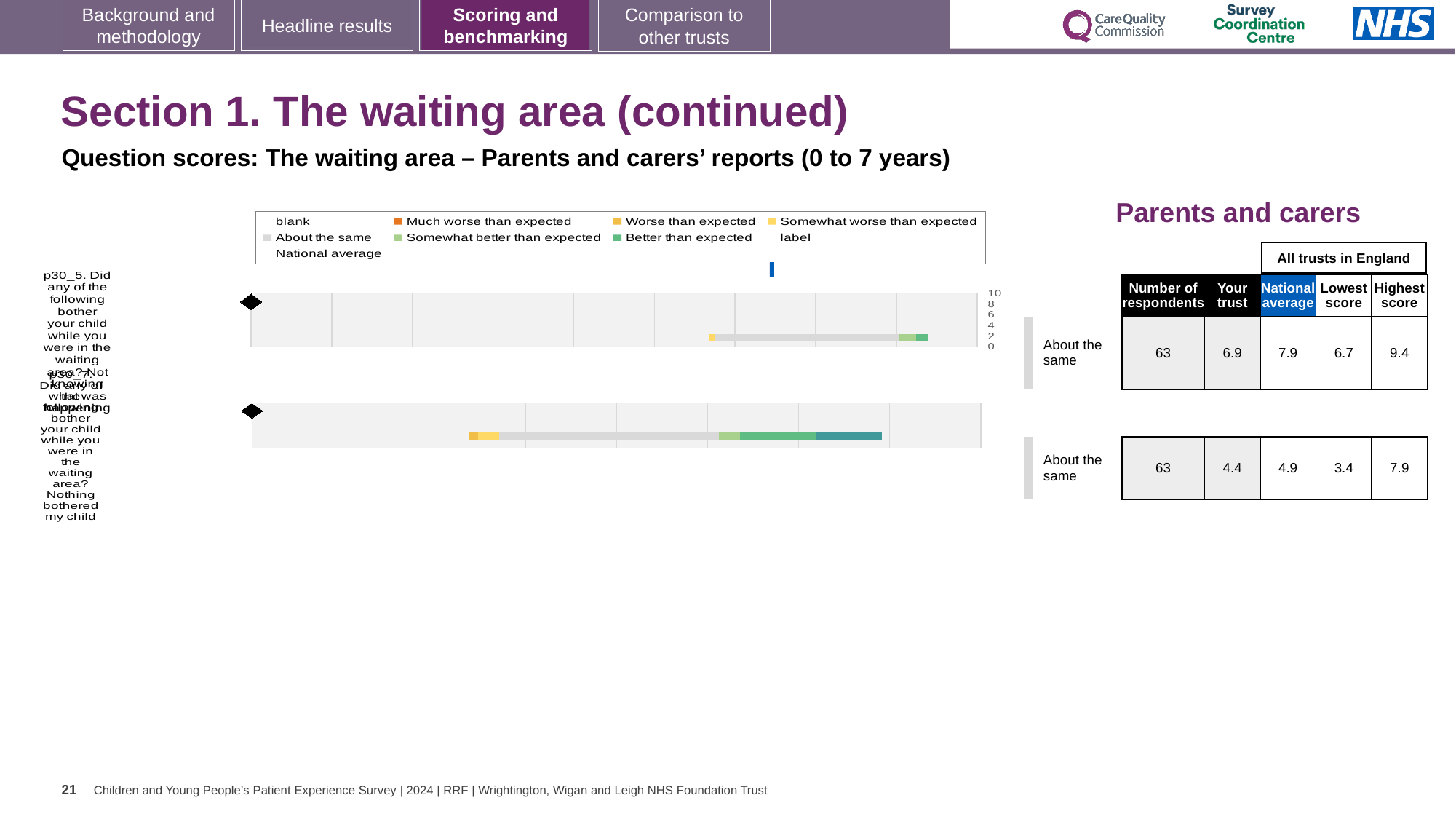
How many questions (bars) are plotted in the chart? 2 What is the maximum value shown on the chart's score axis? 10 What benchmark category is given for question p30_7? About the same What is the difference between the highest score and the lowest score for question p30_5? 2.7 By how much does the national average exceed the 'Your trust' score for question p30_7? 0.5 What is the highest score among all trusts in England for question p30_7? 7.9 What is the 'Your trust' score for question p30_5 (Did any of the following bother your child while you were in the waiting area? Not knowing what was happening)? 6.9 What does the blue marker in the legend represent? National average What kind of chart is used to show the question scores for the waiting area? bar chart How many respondents answered question p30_7? 63 Which question has the higher 'Your trust' score, p30_5 or p30_7? p30_5 What is the national average score for question p30_7 (Nothing bothered my child)? 4.9